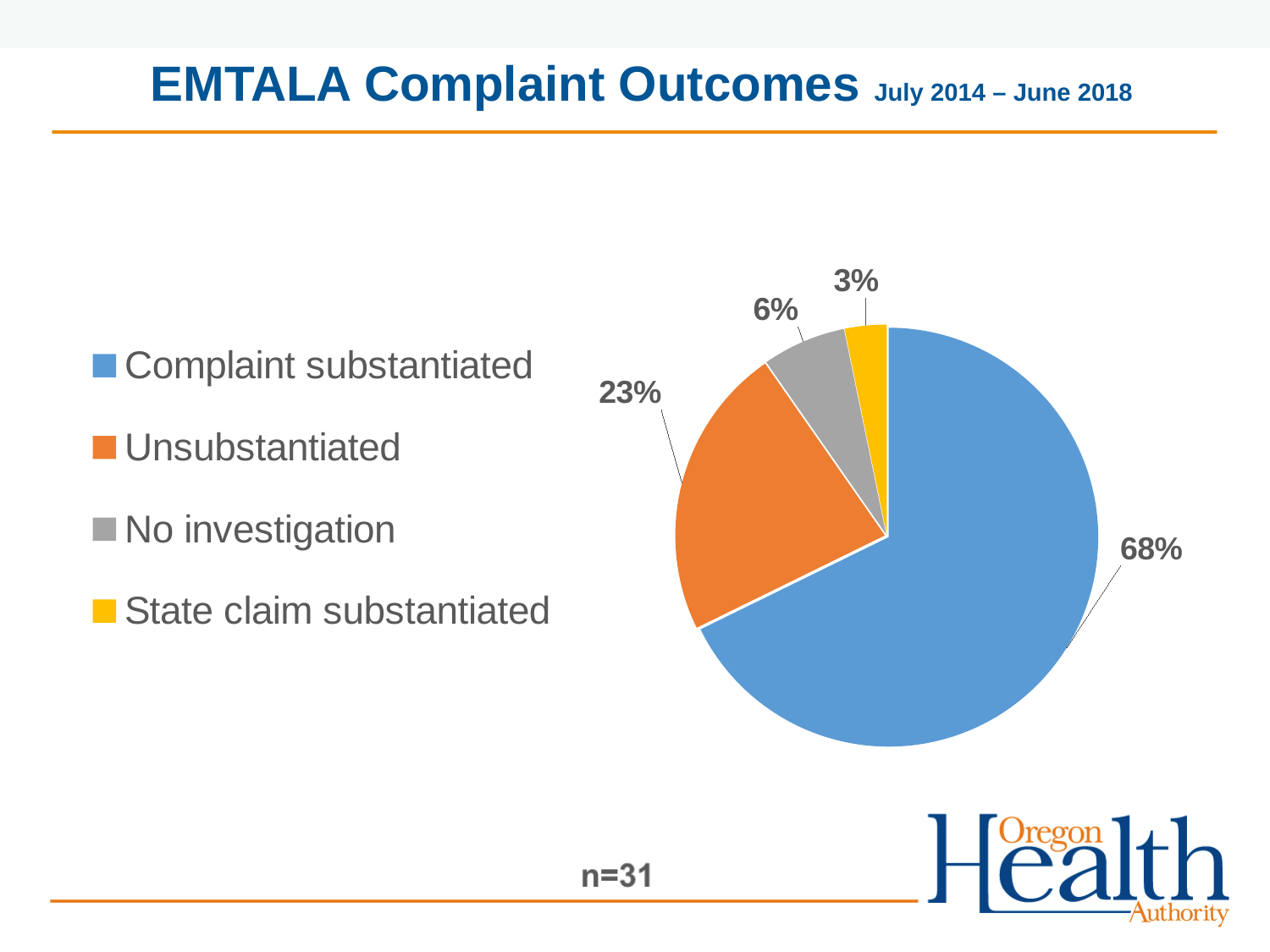
What is the difference in percentage points between Complaint substantiated and Unsubstantiated? 45 How many categories does the pie chart show? 4 What share of the pie is State claim substantiated? 3% What share of the pie is Complaint substantiated? 68% What share of the pie is Unsubstantiated? 23% What is the sample size (n) shown on the slide? n=31 Which is larger, the share for No investigation or the share for State claim substantiated? No investigation What colour is the Unsubstantiated slice? orange Which category has the largest slice of the pie? Complaint substantiated What kind of chart is shown on the slide? pie chart Which category has the smallest slice of the pie? State claim substantiated